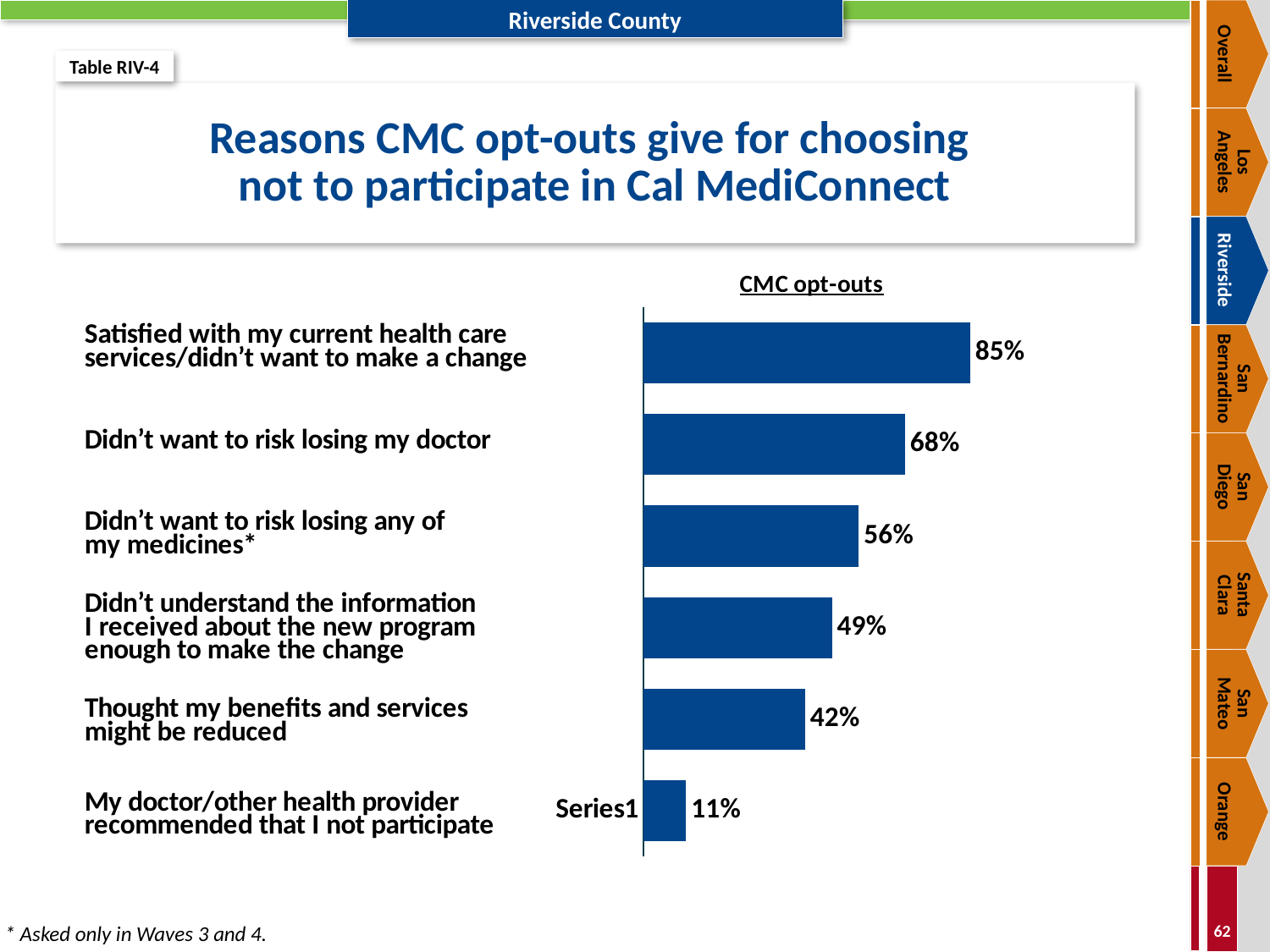
Which reason has the lowest percentage in the chart? My doctor/other health provider recommended that I not participate What percentage of CMC opt-outs said they didn't want to risk losing their doctor? 68% What is the difference between the highest and lowest percentages in the chart? 74% What is the heading shown above the bars in the chart? CMC opt-outs Which reason has the highest percentage in the chart? Satisfied with my current health care services/didn't want to make a change What is the difference between the percentage for 'Didn't want to risk losing my doctor' and 'Thought my benefits and services might be reduced'? 26% Which is larger: the percentage for 'Didn't understand the information I received about the new program enough to make the change' or for 'Thought my benefits and services might be reduced'? Didn't understand the information I received about the new program enough to make the change How many reasons (categories) are plotted in the chart? 6 What percentage of CMC opt-outs said they were satisfied with their current health care services/didn't want to make a change? 85% What value is shown for 'Didn't want to risk losing any of my medicines'? 56% What percentage of CMC opt-outs said their doctor/other health provider recommended that they not participate? 11% What kind of chart is shown on the slide? Bar chart